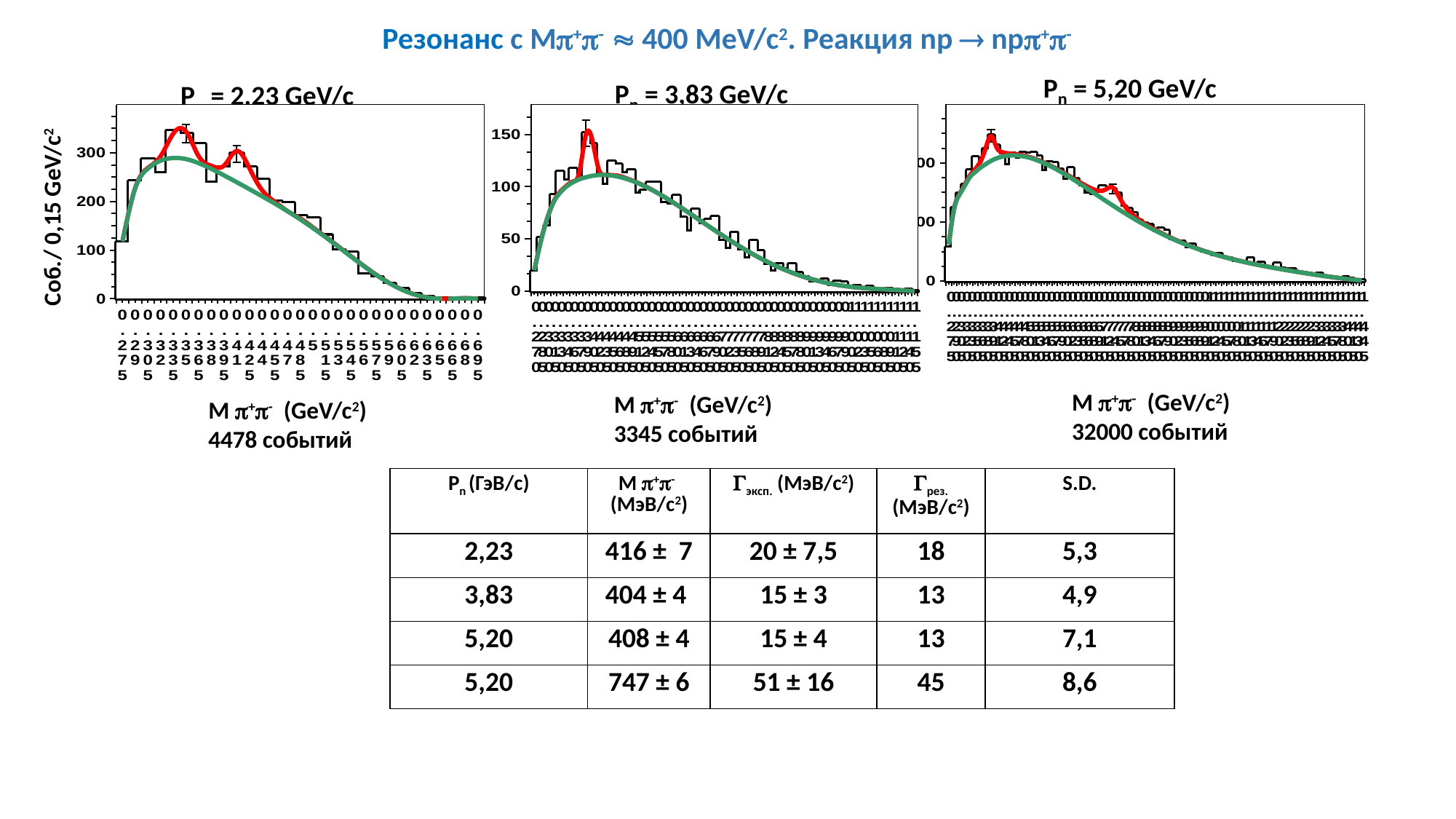
In the chart titled "Pn = 5,20 GeV/c", after the peak, do the values rise or fall as you move right along the x axis? fall How many charts are shown on the slide? 3 How many events are stated below the chart titled "Pn = 5,20 GeV/c"? 32000 событий In the chart titled "Pn = 2,23 GeV/c", is the highest point of the red fitted curve greater or less than 300? greater What kind of chart is shown under the title "Pn = 2,23 GeV/c"? histogram (bar chart) with fitted curves In the chart titled "Pn = 2,23 GeV/c", is the maximum of the green curve greater or less than 300? less In the chart titled "Pn = 3,83 GeV/c", is the value at the far right end of the x axis greater or less than 50? less What is the y-axis label of the left chart? Соб./ 0,15 GeV/c² Which chart has the highest y-axis tick value: the one for Pn = 2,23 GeV/c or the one for Pn = 3,83 GeV/c? Pn = 2,23 GeV/c